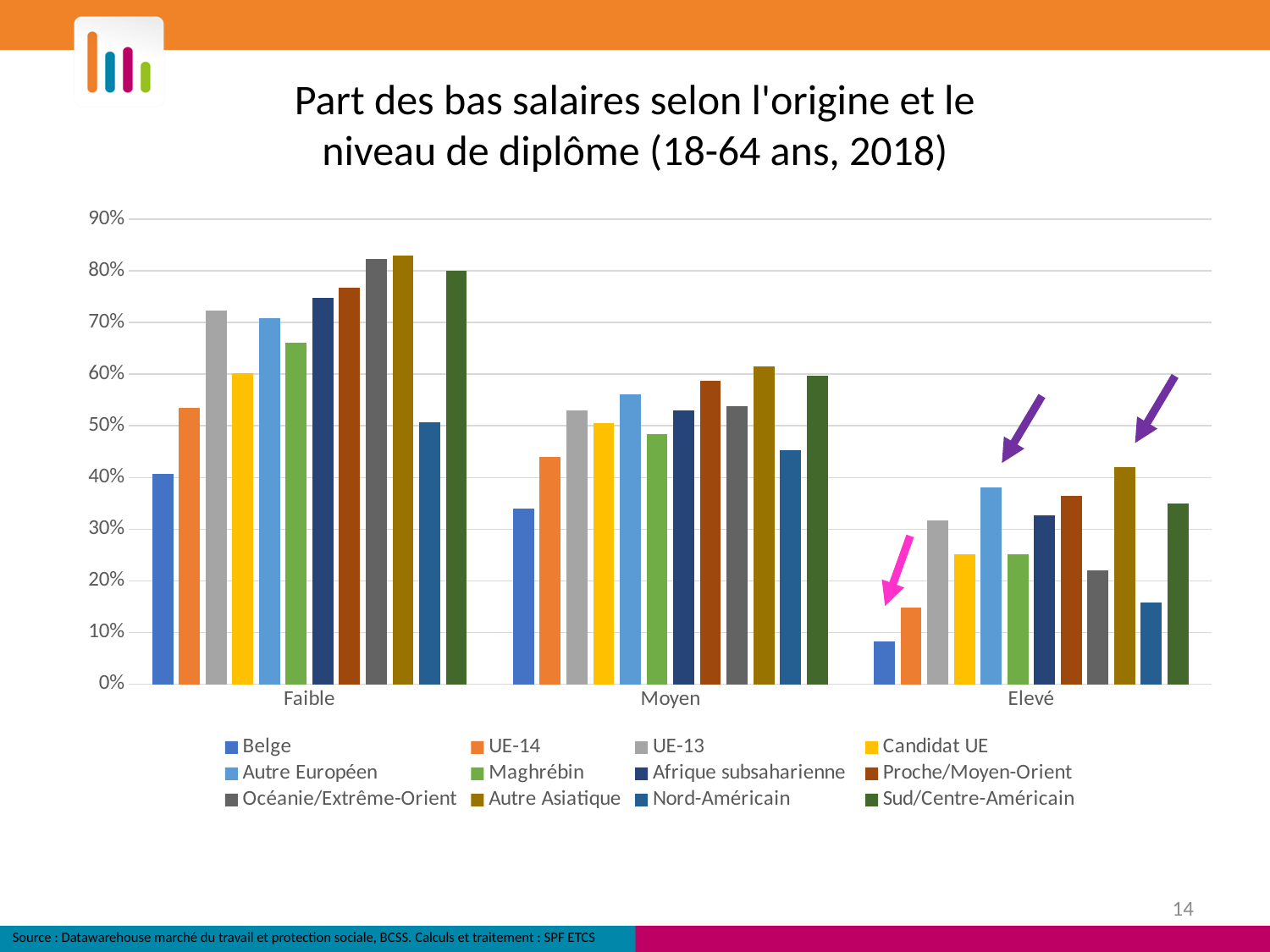
Do the values for Belge rise or fall from Faible to Elevé? fall Which origin group has the lowest value in the Elevé category? Belge Is the value for Belge in the Elevé category greater or less than 10%? less In the Faible category, which is larger: UE-13 or Candidat UE? UE-13 How many series does the legend list? 12 Is the value for Autre Asiatique in the Faible category greater or less than 80%? greater Which origin group has the lowest value in the Faible category? Belge How many diploma-level categories are shown on the x axis? 3 Which origin group has the highest value in the Elevé category? Autre Asiatique What is the title of the chart? Part des bas salaires selon l'origine et le niveau de diplôme (18-64 ans, 2018) Is the value for Belge in the Faible category greater or less than 50%? less What kind of chart is shown on the slide? bar chart